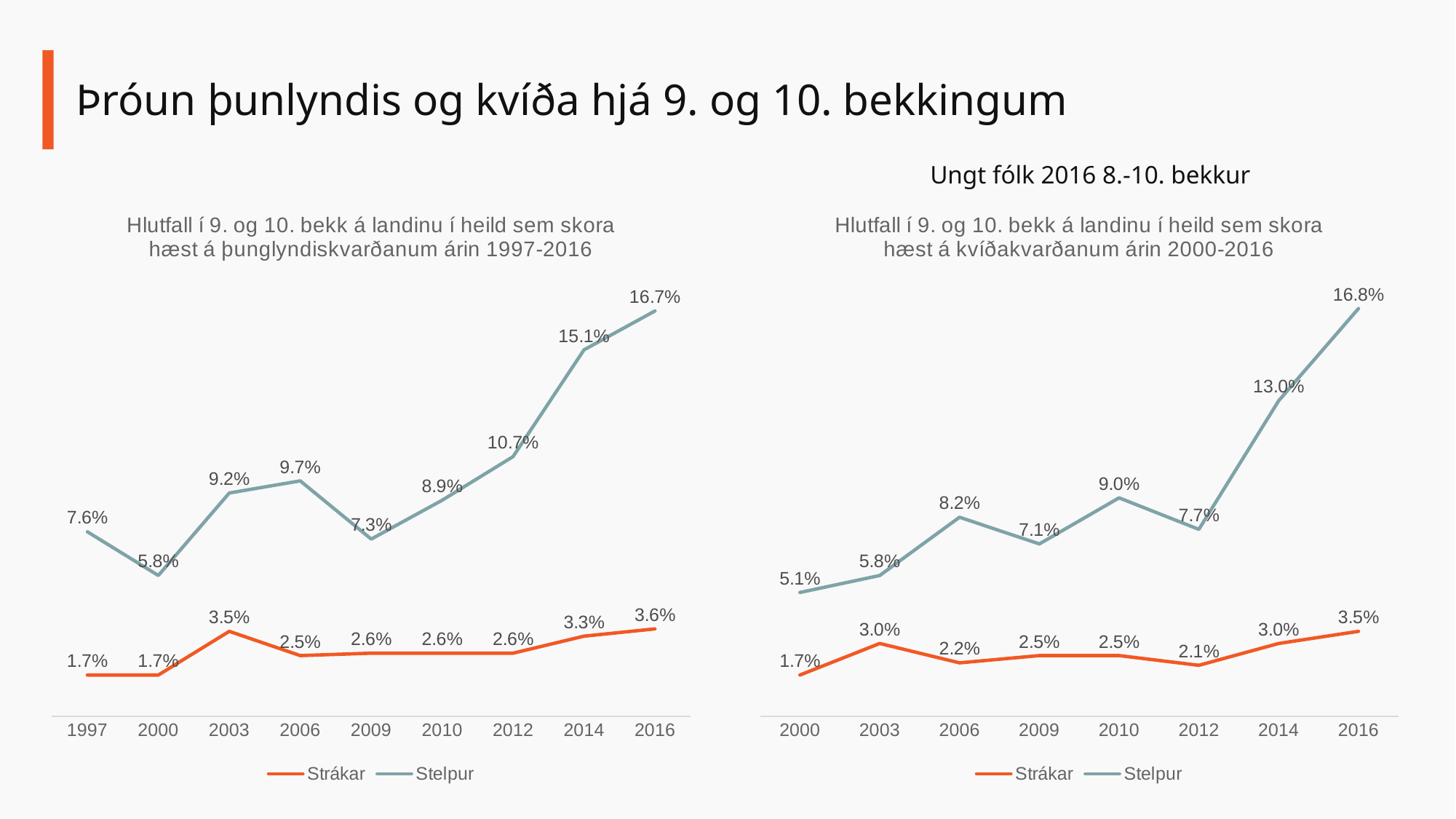
In the left chart (þunglyndiskvarðanum 1997-2016), what is the value for Stelpur in 2016? 16.7% How many series does the legend of the right chart (kvíðakvarðanum 2000-2016) list? 2 What kind of chart is the left chart (þunglyndiskvarðanum 1997-2016)? Line chart In the left chart (þunglyndiskvarðanum 1997-2016), what is the difference between Stelpur and Strákar in 2016? 13.1% How many years are shown on the x axis of the left chart (þunglyndiskvarðanum 1997-2016)? 9 In the right chart (kvíðakvarðanum 2000-2016), what is the value for Stelpur in 2014? 13.0% In the right chart (kvíðakvarðanum 2000-2016), which is larger for Stelpur: the value in 2006 or the value in 2009? 2006 In the right chart (kvíðakvarðanum 2000-2016), what is the difference between the Stelpur values in 2016 and 2014? 3.8% In the right chart (kvíðakvarðanum 2000-2016), what is the value for Strákar in 2012? 2.1% In the left chart (þunglyndiskvarðanum 1997-2016), what is the value for Strákar in 2003? 3.5% In the left chart (þunglyndiskvarðanum 1997-2016), which year has the lowest value for Stelpur? 2000 In the right chart (kvíðakvarðanum 2000-2016), which year has the highest value for Stelpur? 2016